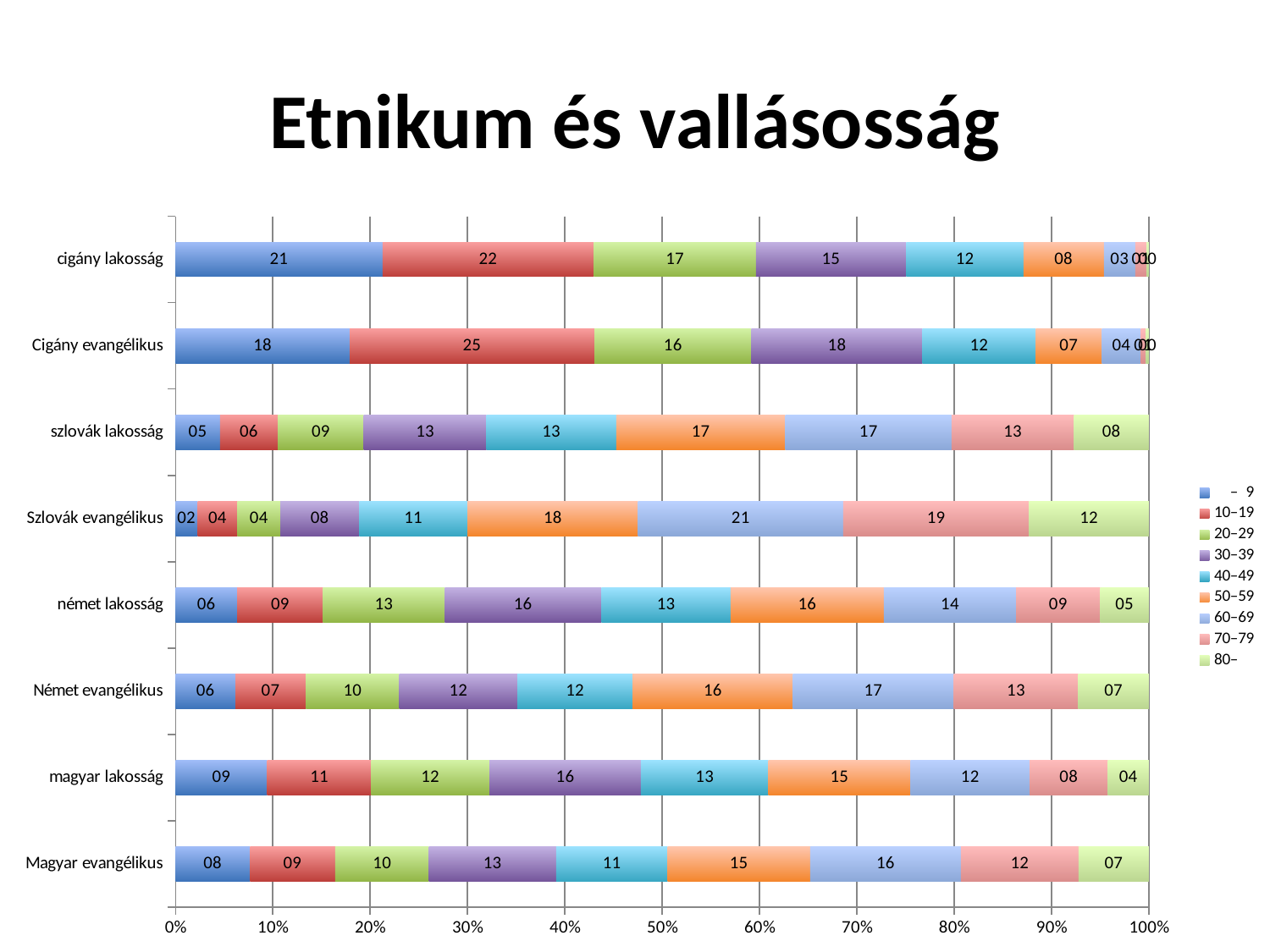
What is the value of the 30–39 series for német lakosság? 16 What kind of chart is shown on the slide? Stacked bar chart What is the difference between the 10–19 values for Cigány evangélikus and magyar lakosság? 14 What is the value of the 60–69 series for Szlovák evangélikus? 21 How many series does the legend list? 9 Which category has the highest value for the –9 series? cigány lakosság Which category has the lowest value for the –9 series? Szlovák evangélikus What is the title of the chart? Etnikum és vallásosság What is the value of the 10–19 series for cigány lakosság? 22 Which is larger: the 50–59 value for szlovák lakosság or the 50–59 value for Magyar evangélikus? szlovák lakosság What is the value of the 80– series for Magyar evangélikus? 07 How many categories are shown on the vertical axis of the chart? 8